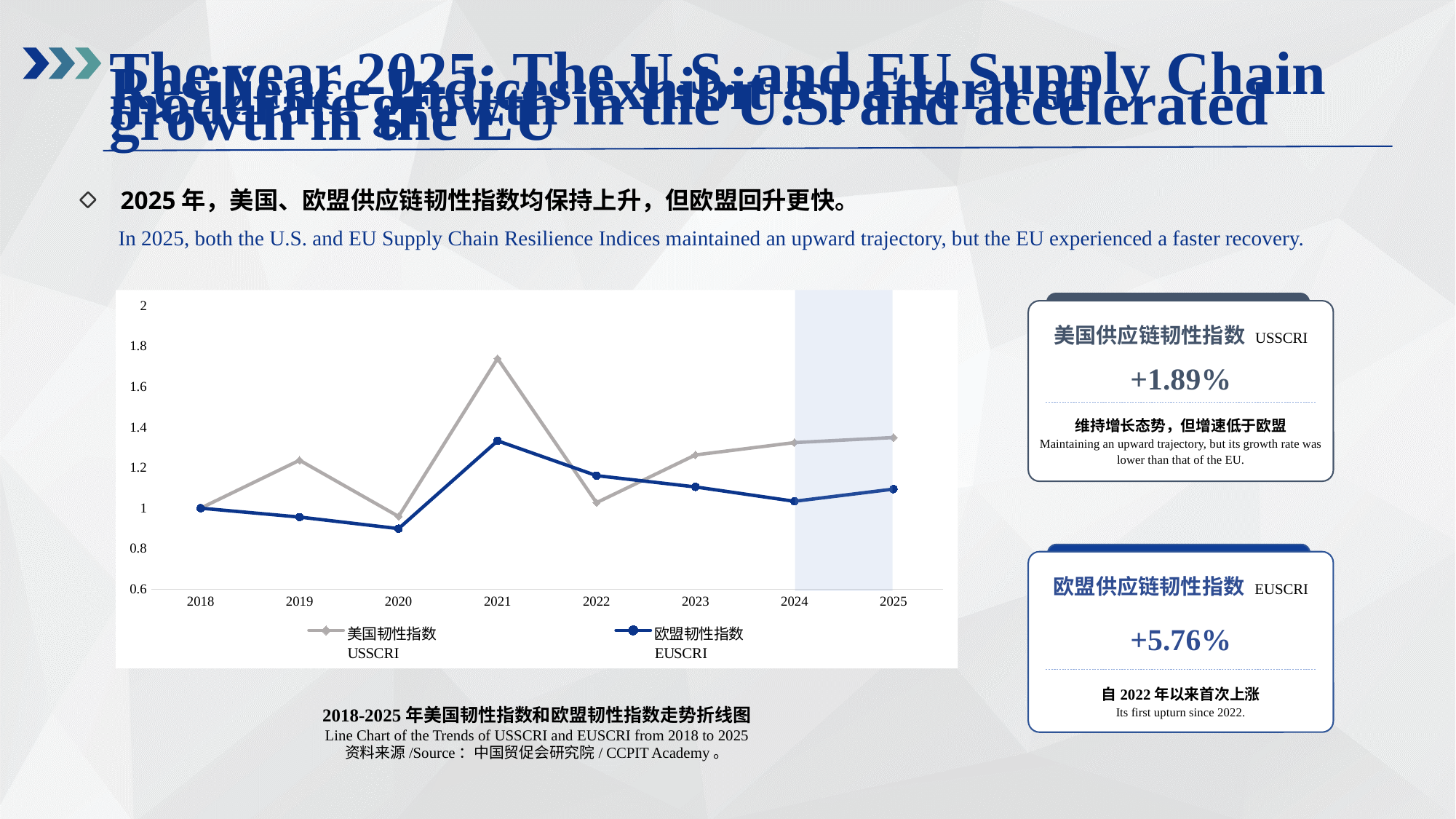
Is the USSCRI value for 2025 greater or less than 1.2? greater How many series does the chart's legend list? 2 Is the EUSCRI value for 2020 greater or less than 1? less Which series has the higher value in 2024, USSCRI or EUSCRI? USSCRI Which colour is used for the EUSCRI line in the chart? blue Is the USSCRI value for 2021 greater or less than 1.6? greater What kind of chart is shown on the slide? line chart How many years are plotted along the x axis of the chart? 8 In which year does the USSCRI series reach its highest value? 2021 In which year does the EUSCRI series reach its lowest value? 2020 Which series has the higher value in 2022, USSCRI or EUSCRI? EUSCRI Does the EUSCRI series rise or fall from 2021 to 2024? fall